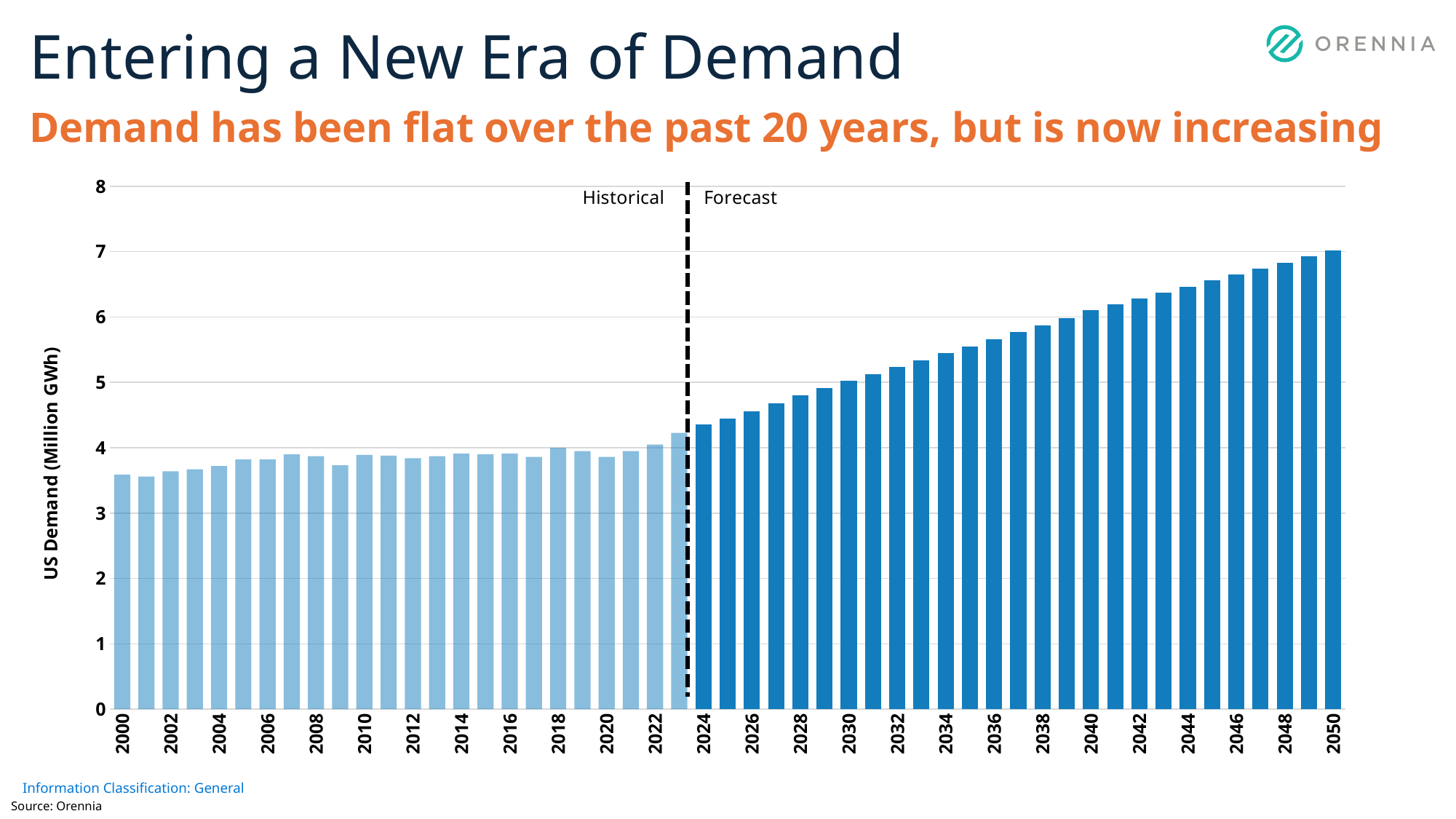
Which is larger, the value for 2050 or the value for 2000? 2050 Which year has the highest US demand in the chart? 2050 Is the value for 2000 greater or less than 4? less Is the value for 2024 greater or less than 4? greater What kind of chart is shown on the slide? bar chart What is the label on the vertical axis of the chart? US Demand (Million GWh) Is the value for 2050 greater or less than 6? greater Do the forecast values rise or fall from 2024 to 2050? rise What two labels appear on either side of the dashed vertical line in the chart? Historical and Forecast Which is larger, the value for 2024 or the value for 2022? 2024